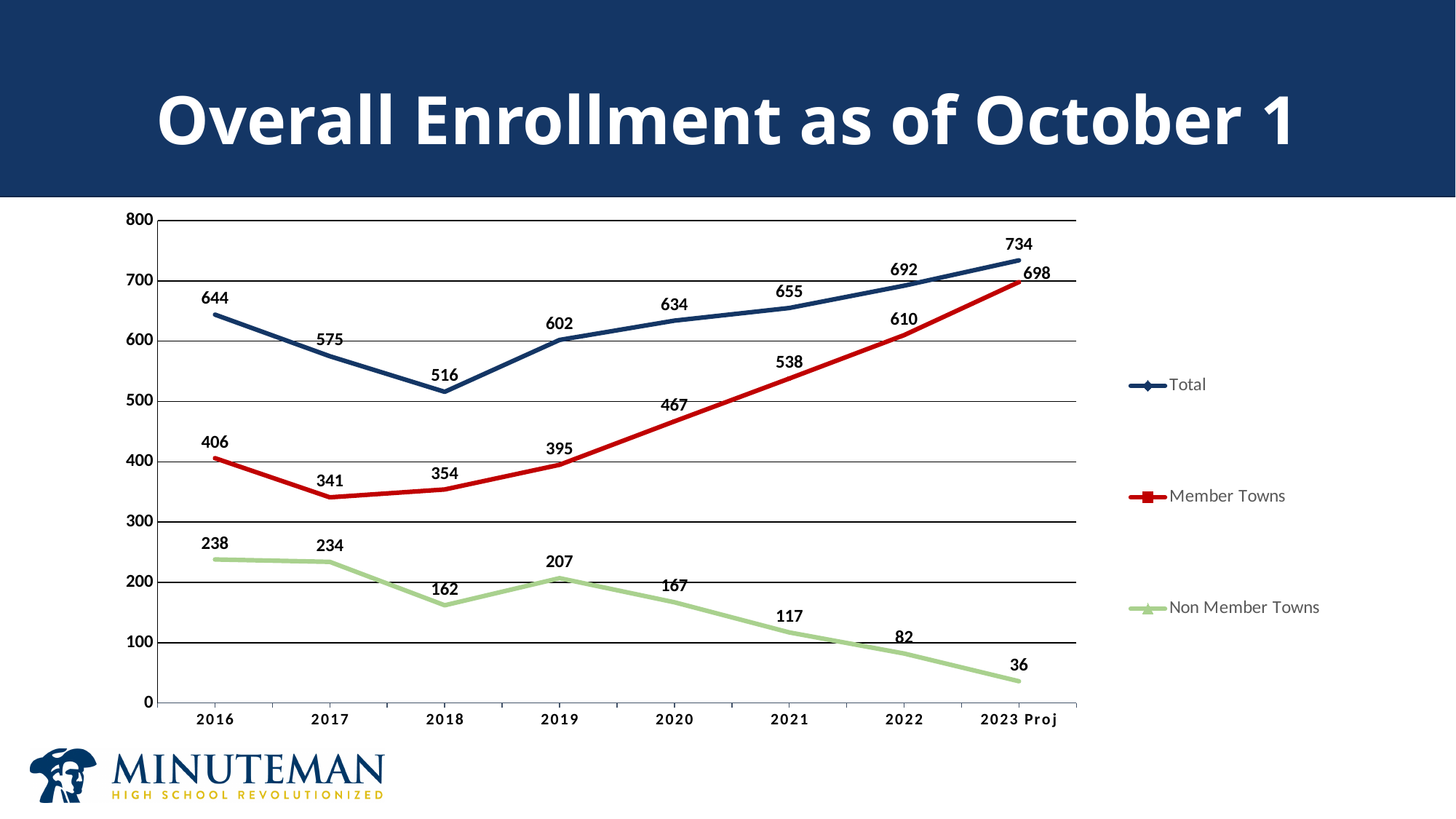
Does the Non Member Towns series generally rise or fall from 2019 to 2023 Proj? fall How many series does the legend list? 3 What is the Non Member Towns value for 2019? 207 What is the difference between the Total and Member Towns values in 2016? 238 What is the Total enrollment value for 2018? 516 In which year is the Total series at its lowest? 2018 In which year is the Non Member Towns series at its highest? 2016 What is the Member Towns value for 2023 Proj? 698 Is the Member Towns value for 2021 greater or less than 500? greater What kind of chart is shown on the slide? line chart Which is larger: the Member Towns value in 2017 or the Member Towns value in 2018? 2018 How many years are shown on the x axis? 8